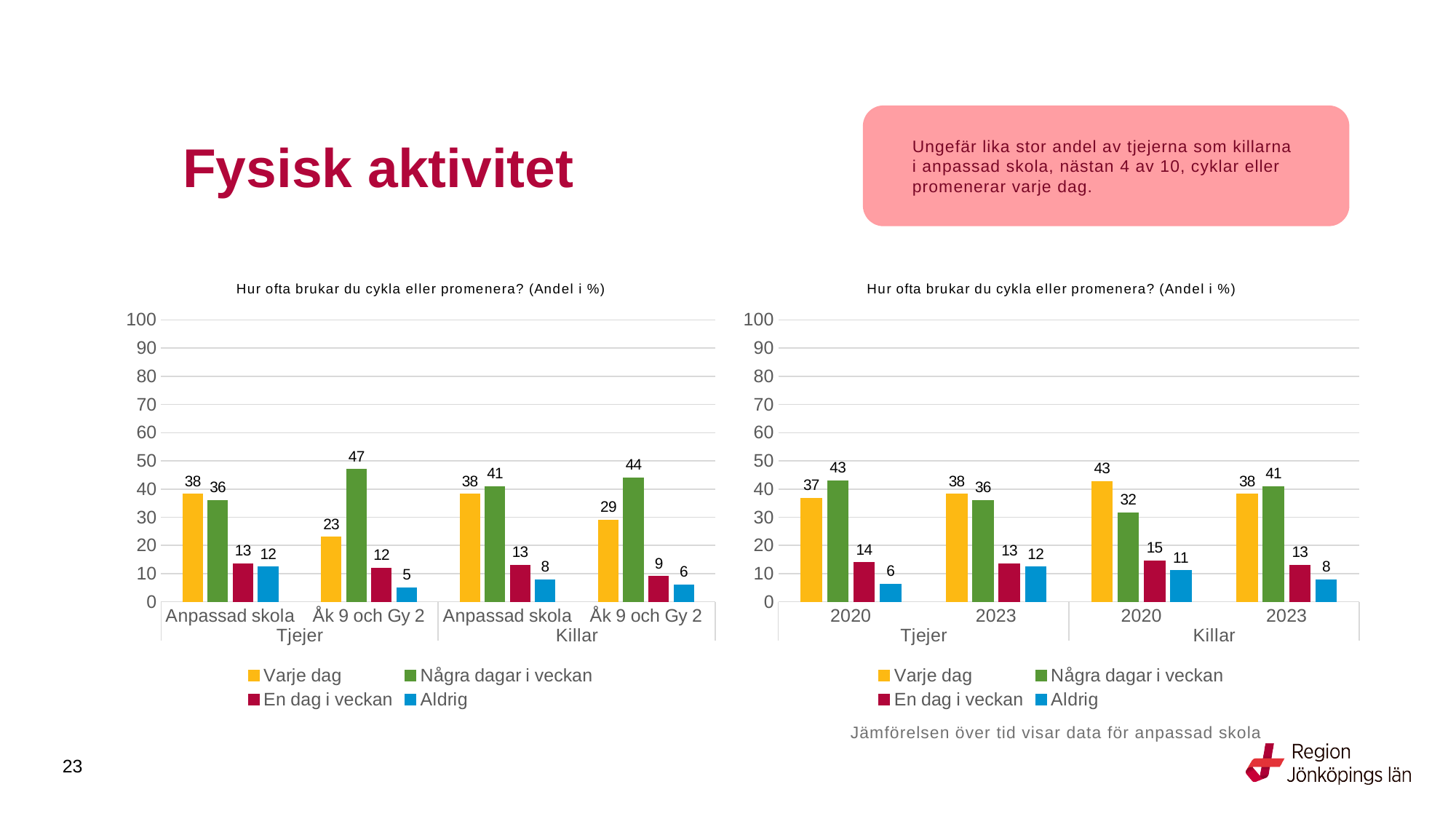
In the right chart, which series has the lowest value for Tjejer in 2020? Aldrig In the right chart, what is the difference between 'Varje dag' for Killar in 2020 and in 2023? 5 In the left chart, what is the value for 'Några dagar i veckan' for Tjejer in Åk 9 och Gy 2? 47 In the right chart, what is the value for 'Några dagar i veckan' for Tjejer in 2020? 43 What type of chart is the left chart? Bar chart In the right chart, is the value for 'Aldrig' for Tjejer larger in 2020 or in 2023? 2023 In the right chart, what is the value for 'Varje dag' for Killar in 2020? 43 In the left chart, what is the difference between 'Några dagar i veckan' and 'Varje dag' for Tjejer in Åk 9 och Gy 2? 24 In the left chart, which series has the highest value for Killar in Åk 9 och Gy 2? Några dagar i veckan In the left chart, what is the value for 'Varje dag' for Tjejer in Anpassad skola? 38 How many series does the legend of the right chart list? 4 In the left chart, what is the value for 'Aldrig' for Killar in Åk 9 och Gy 2? 6